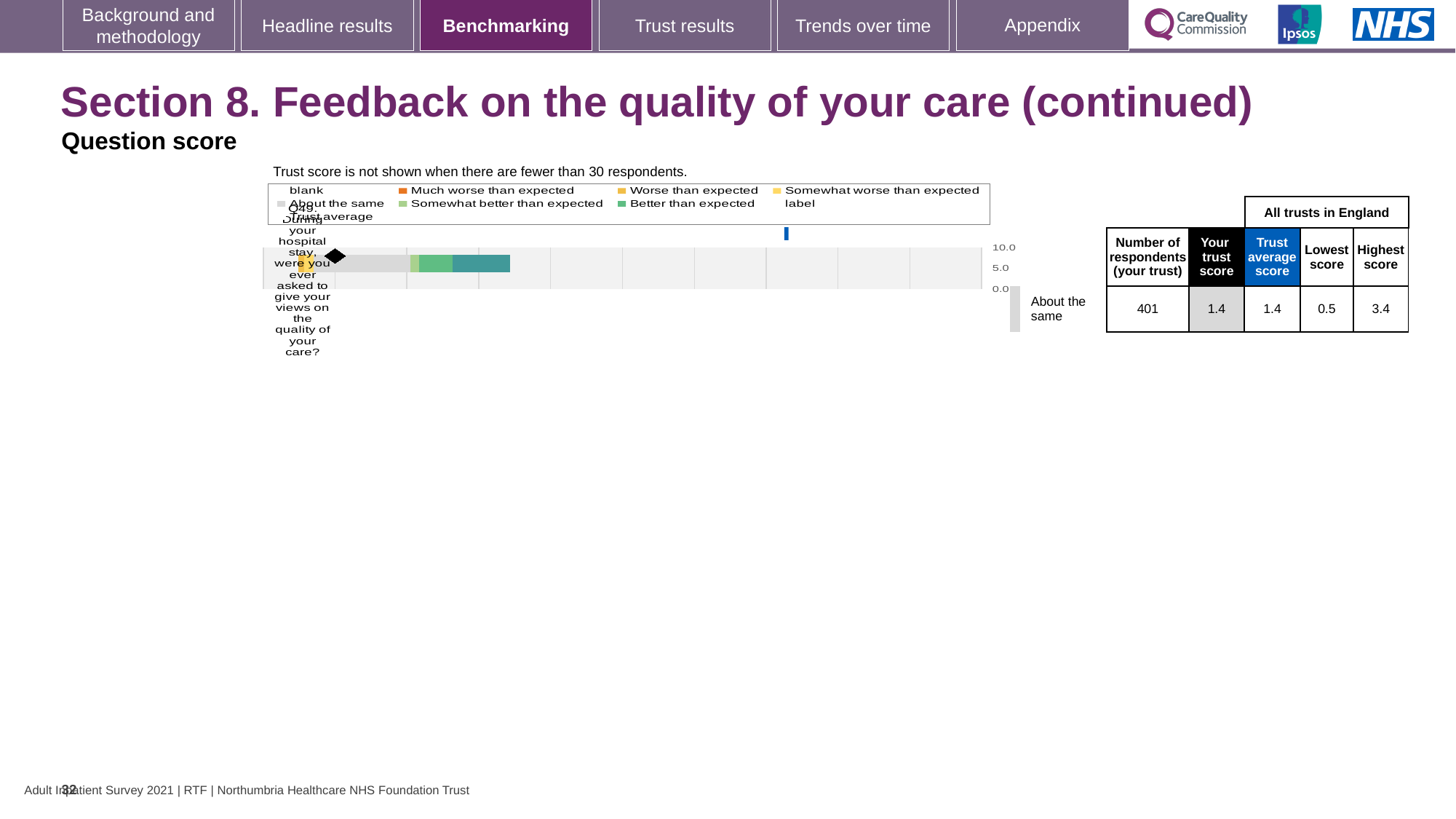
What is the lowest score among all trusts in England for Q49? 0.5 According to the note above the chart, when is the trust score not shown? When there are fewer than 30 respondents What is the highest tick value shown on the chart's axis? 10.0 What is the trust average score for Q49? 1.4 Is the trust score for Q49 greater or less than 5.0 on the chart's axis? less How many questions (categories) are plotted in the benchmarking chart? 1 What kind of chart is used to show the Q49 benchmarking result? bar chart How many respondents from the trust answered Q49? 401 What is the difference between the highest and lowest scores for Q49 across all trusts in England? 2.9 Which benchmark category is the trust's Q49 result placed in? About the same What is the trust score for Q49 shown alongside the chart? 1.4 What is the highest score among all trusts in England for Q49? 3.4